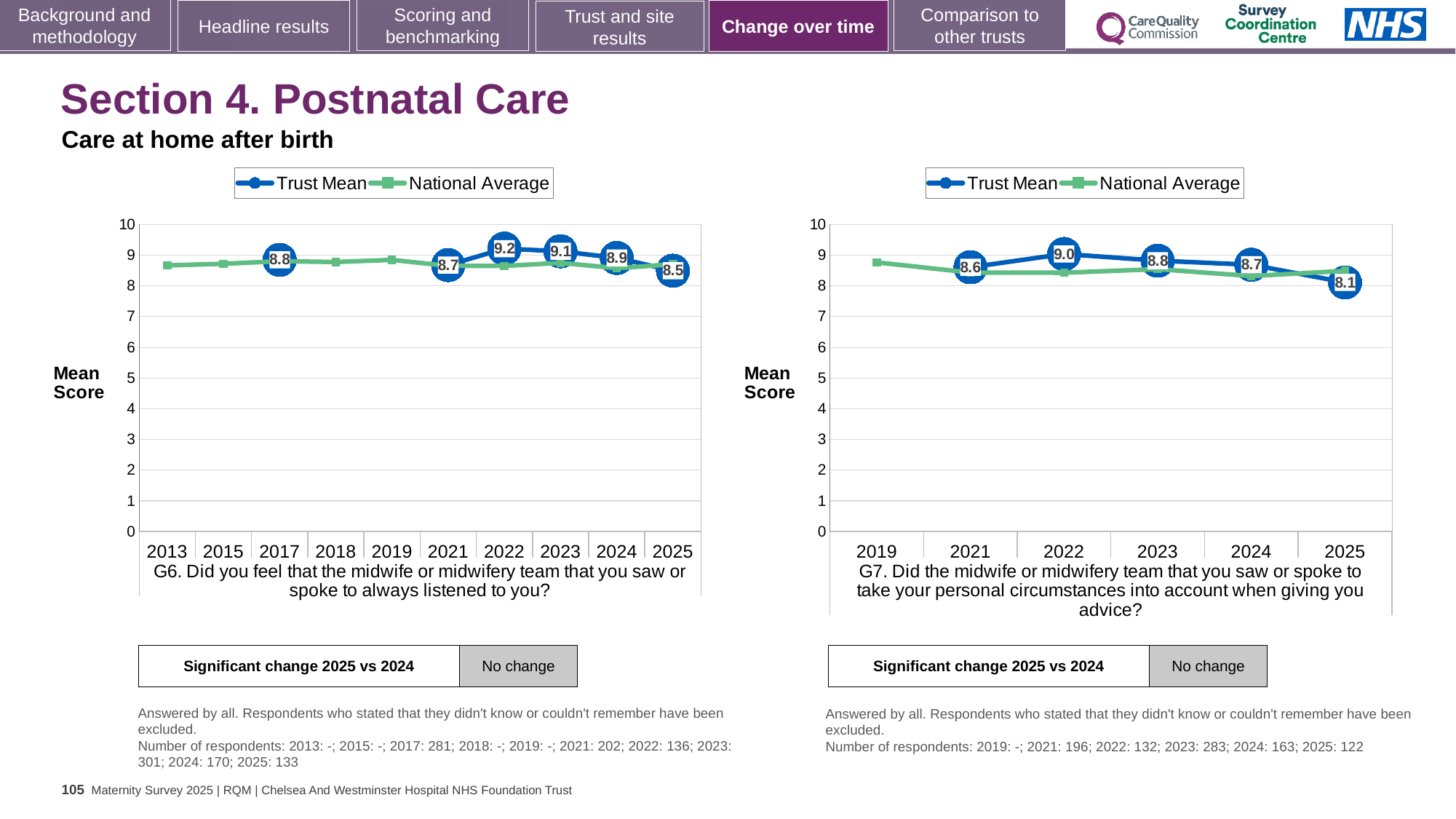
In the G6 chart on the left, what is the Trust Mean score for 2022? 9.2 In the G6 chart on the left, which year has the highest Trust Mean score? 2022 In the G6 chart on the left, what is the Trust Mean score for 2025? 8.5 How many series does the legend of the G7 chart on the right list? 2 In the G7 chart on the right, which is larger: the Trust Mean score for 2022 or for 2024? 2022 How many years are shown on the x axis of the G6 chart on the left? 10 In the G7 chart on the right, what is the Trust Mean score for 2025? 8.1 What kind of chart is the G6 chart on the left? Line chart In the G7 chart on the right, is the National Average value for 2019 greater or less than 8? greater In the G7 chart on the right, what is the Trust Mean score for 2021? 8.6 In the G7 chart on the right, which year has the lowest Trust Mean score? 2025 In the G6 chart on the left, what is the difference between the Trust Mean scores for 2022 and 2025? 0.7